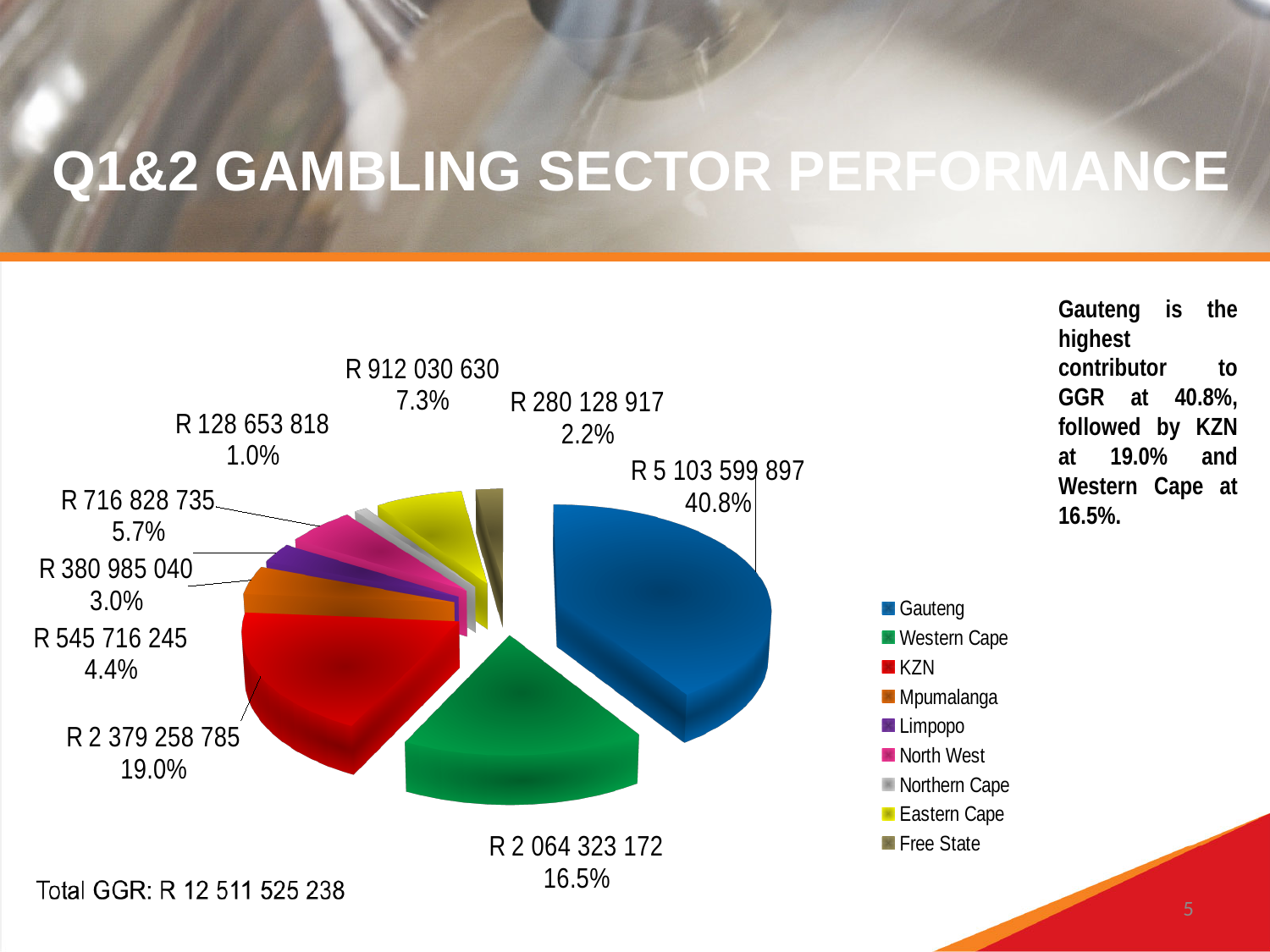
What is the total GGR shown on the slide? R 12 511 525 238 How many percentage points higher is Gauteng's share than KZN's share? 21.8 What type of chart is shown on the slide? Pie chart Which contributes a larger share of GGR, KZN or Western Cape? KZN What share of GGR does Mpumalanga contribute? 4.4% What share of GGR does Eastern Cape contribute? 7.3% Which province is the lowest contributor to GGR? Northern Cape What is the GGR value for Gauteng? R 5 103 599 897 What is the GGR value for KZN? R 2 379 258 785 What is the GGR value for Western Cape? R 2 064 323 172 How many provinces are listed in the legend? 9 Which province is the highest contributor to GGR? Gauteng